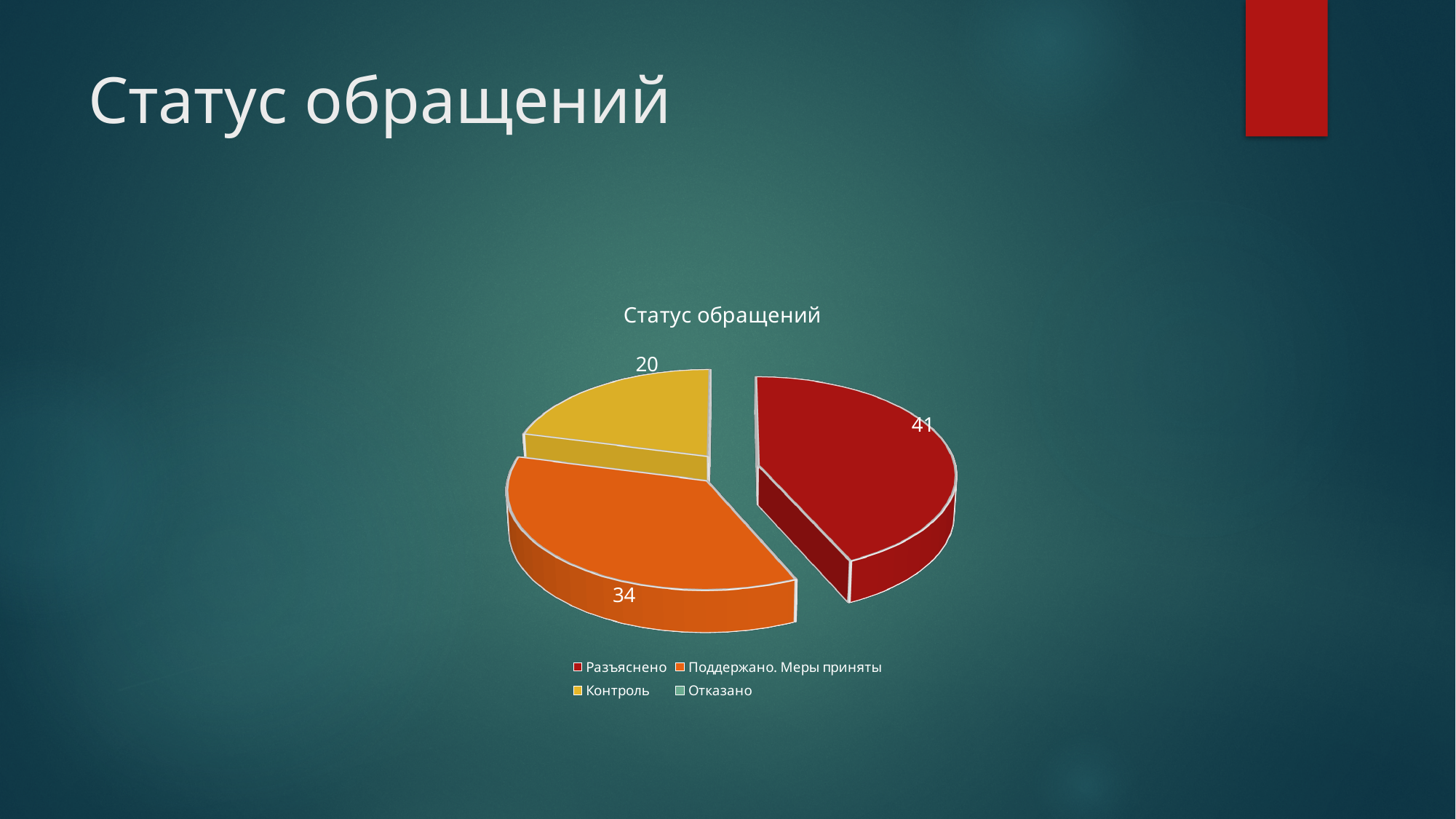
How many categories does the legend list? 4 Which category has the smallest printed value? Контроль What is the difference between the values for Разъяснено and Контроль? 21 Which category has the largest slice? Разъяснено What is the difference between the values for Поддержано. Меры приняты and Контроль? 14 What is the value for Разъяснено? 41 Which is larger, the value for Поддержано. Меры приняты or the value for Контроль? Поддержано. Меры приняты What is the value for Контроль? 20 What is the title of the chart? Статус обращений What is the difference between the values for Разъяснено and Поддержано. Меры приняты? 7 What is the value for Поддержано. Меры приняты? 34 What kind of chart is shown on the slide? pie chart